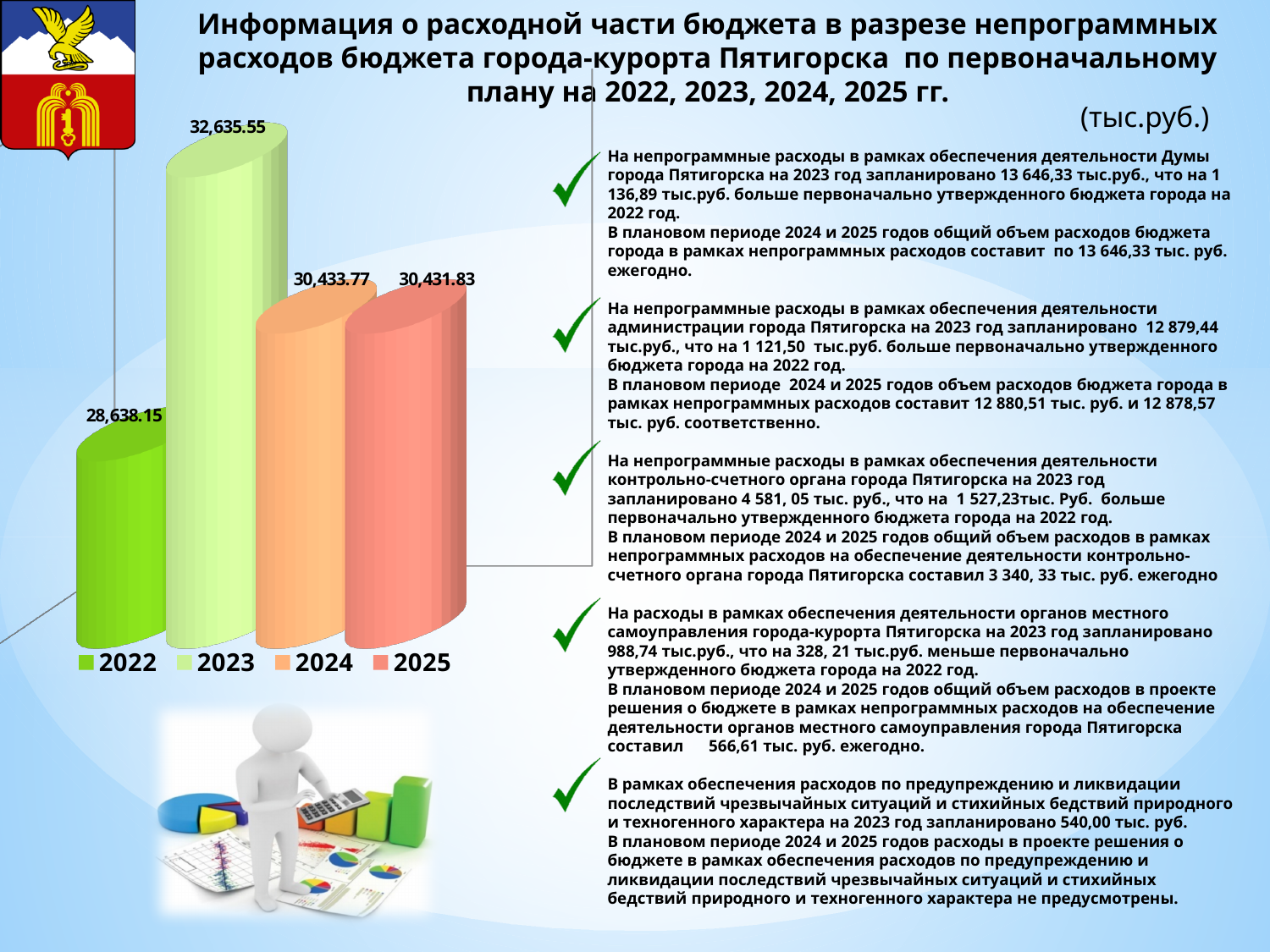
What is the difference between the values for 2023 and 2022? 3,997.40 Does the value rise or fall from 2022 to 2023? rise What is the value shown for 2024 on the chart? 30,433.77 Which is larger, the value for 2023 or the value for 2022? 2023 What is the difference between the values for 2023 and 2024? 2,201.78 What kind of chart is shown on the slide? bar chart What is the value shown for 2025 on the chart? 30,431.83 What is the value shown for 2022 on the chart? 28,638.15 How many series does the chart legend list? 4 Which year has the lowest value on the chart? 2022 What is the value shown for 2023 on the chart? 32,635.55 Which year has the highest value on the chart? 2023